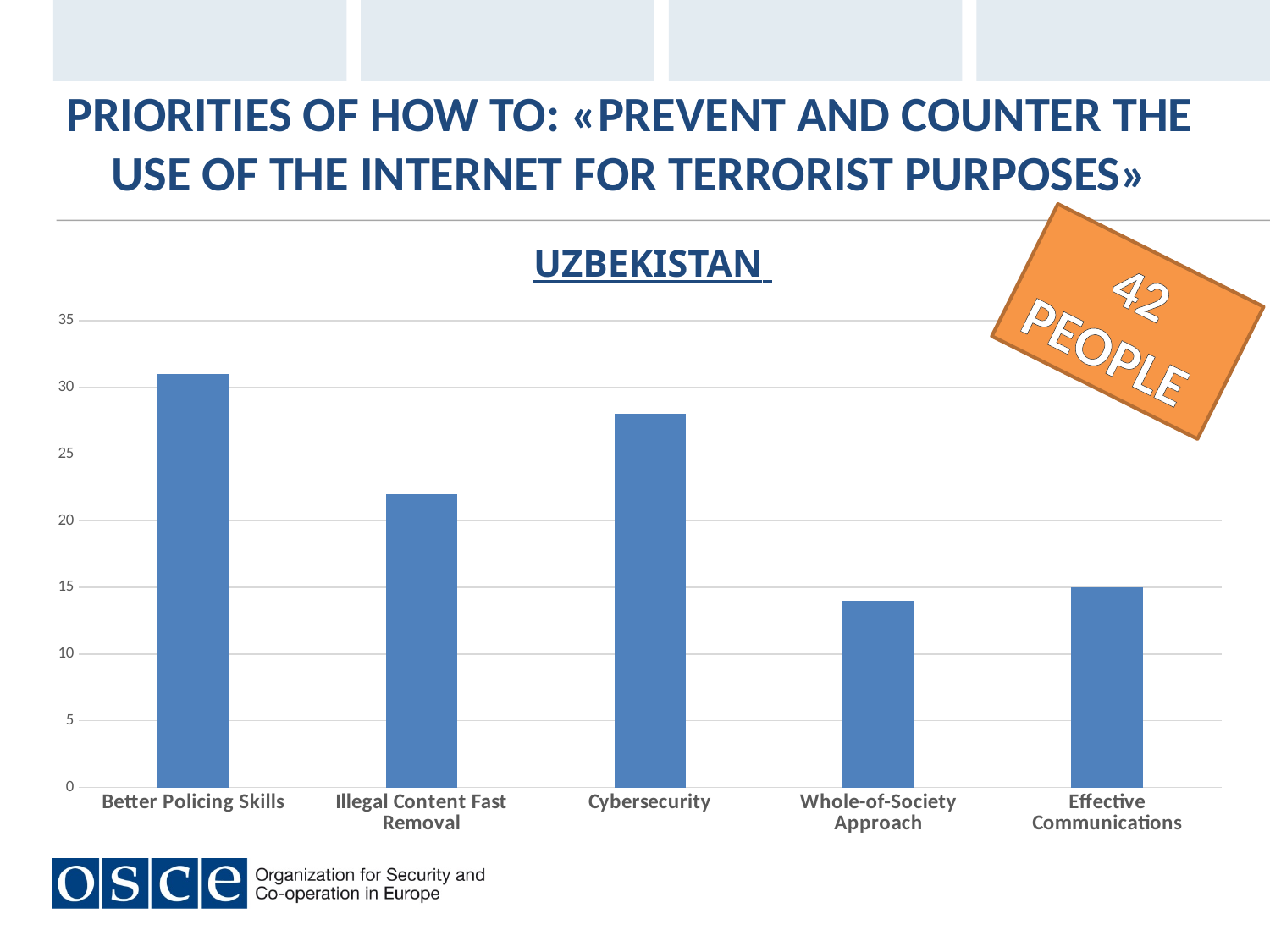
How many categories are shown on the x axis of the chart? 5 Which category has the lowest value in the chart? Whole-of-Society Approach Is the value for Cybersecurity greater or less than 30? less How many people does the orange label on the slide say took part? 42 PEOPLE Is the value for Whole-of-Society Approach greater or less than 15? less Which category has the highest value in the chart? Better Policing Skills Is the value for Illegal Content Fast Removal greater or less than 20? greater What kind of chart is shown on the slide? bar chart Which has a larger value, Better Policing Skills or Cybersecurity? Better Policing Skills Which has a larger value, Cybersecurity or Illegal Content Fast Removal? Cybersecurity What is the title of the chart? UZBEKISTAN